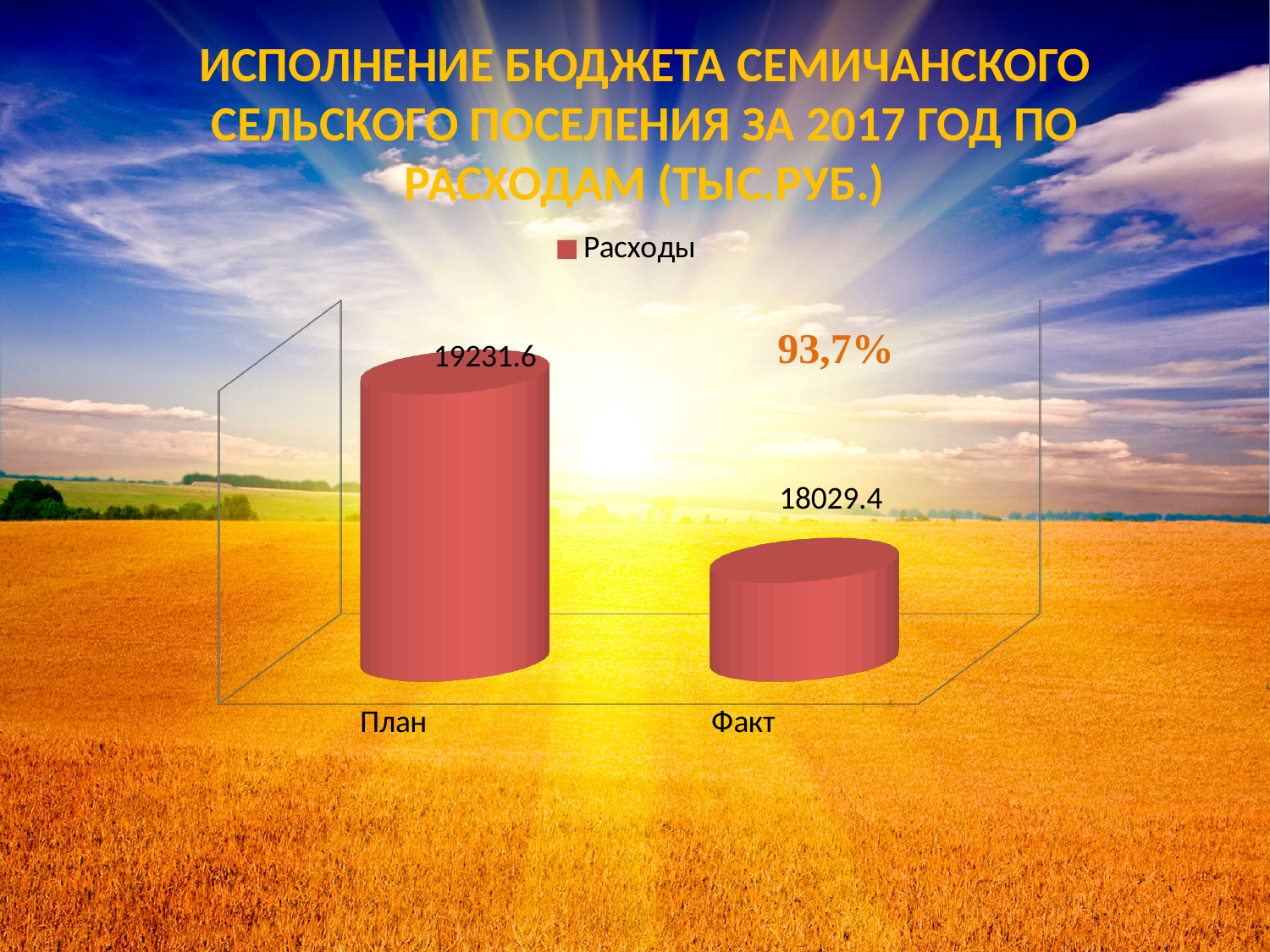
Do the values rise or fall from План to Факт? Fall Which category has the highest value? План How many categories are shown on the chart? 2 What is the value for Факт? 18029.4 How many series does the legend list? 1 Which is larger, the value for План or the value for Факт? План What is the value for План? 19231.6 Which category has the lowest value? Факт What series name is shown in the legend? Расходы What percentage is printed on the chart next to the Факт bar? 93,7% What kind of chart is shown on the slide? Bar chart What is the difference between the values for План and Факт? 1202.2